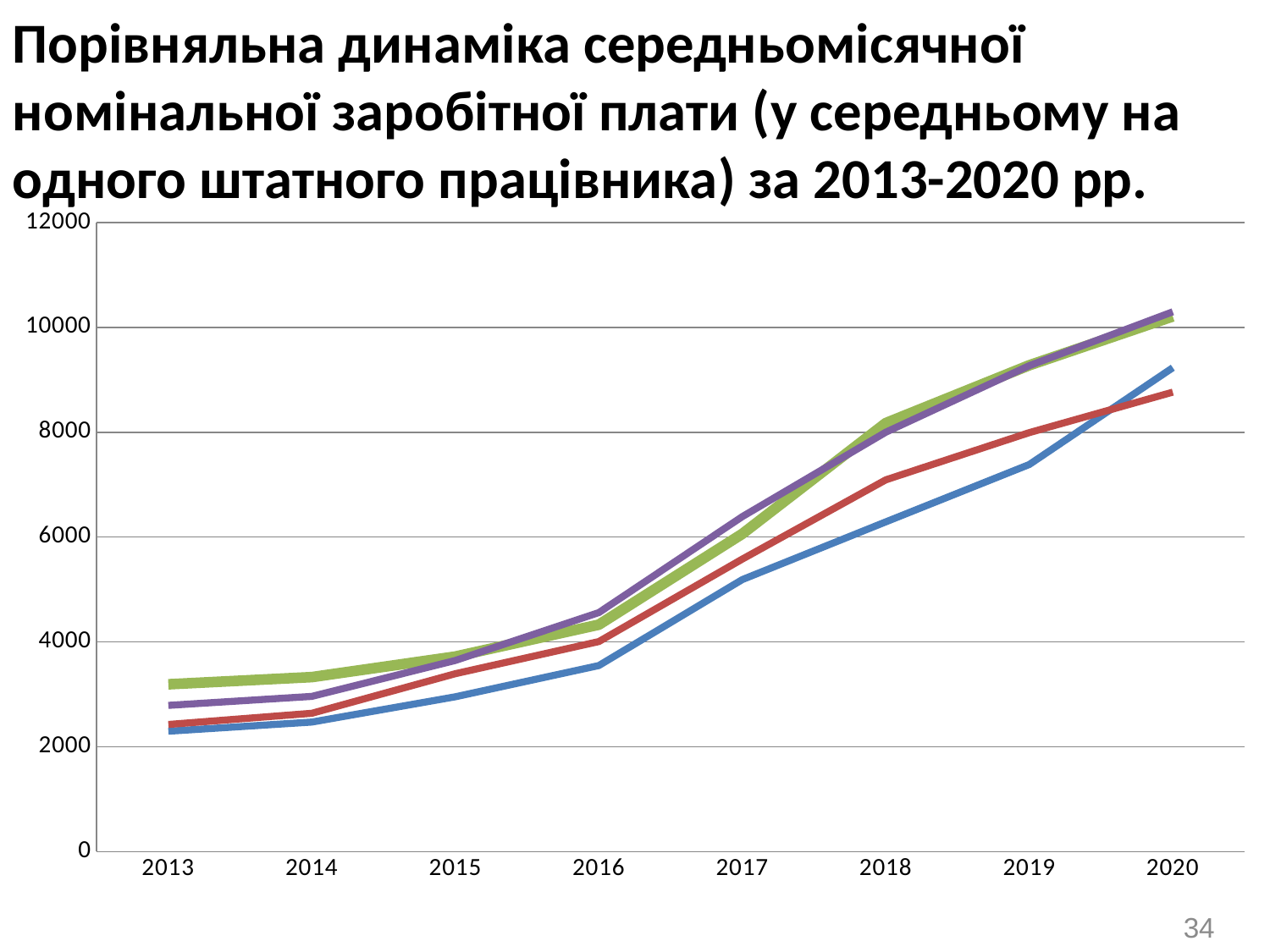
How many years are plotted along the x axis? 8 Is the value of the green line in 2013 greater or less than 2000? greater What kind of chart is shown on the slide? line chart Is the value of the blue line in 2020 greater or less than 8000? greater Do the values of the lines rise or fall from 2013 to 2020? rise In 2020, which line has the higher value, the blue line or the red line? the blue line Is the value of the blue line in 2016 greater or less than 4000? less In 2019, which line has the higher value, the blue line or the red line? the red line Which line has the lowest value in 2013? the blue line How many lines are plotted on the chart? 4